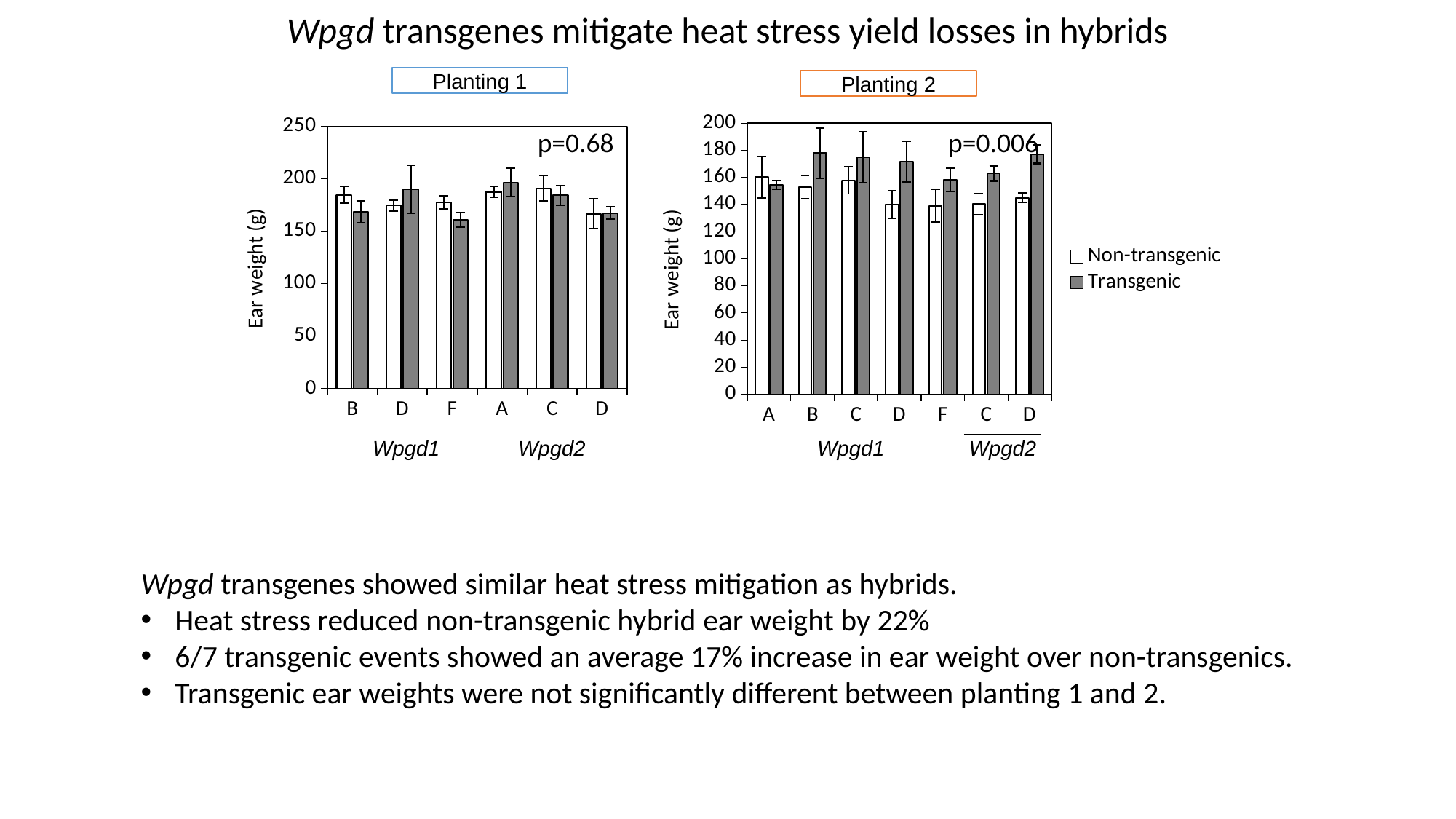
How many event categories are shown on the x axis of the Planting 2 chart? 7 In the Planting 2 chart, is the Transgenic value for event B under Wpgd1 greater or less than 160? greater In the Planting 2 chart, is the Non-transgenic value for event D under Wpgd1 greater or less than 160? less In the Planting 2 chart, for event D under Wpgd1, which is larger: the Non-transgenic or the Transgenic bar? Transgenic How many event categories are shown on the x axis of the Planting 1 chart? 6 What kind of chart is the Planting 1 chart? bar chart What p-value is printed on the Planting 2 chart? p=0.006 In the Planting 1 chart, for event F under Wpgd1, which is larger: the Non-transgenic or the Transgenic bar? Non-transgenic In the Planting 1 chart, is the Non-transgenic value for event B under Wpgd1 greater or less than 150? greater What is the y-axis label of the Planting 1 chart? Ear weight (g) How many series does the legend list? 2